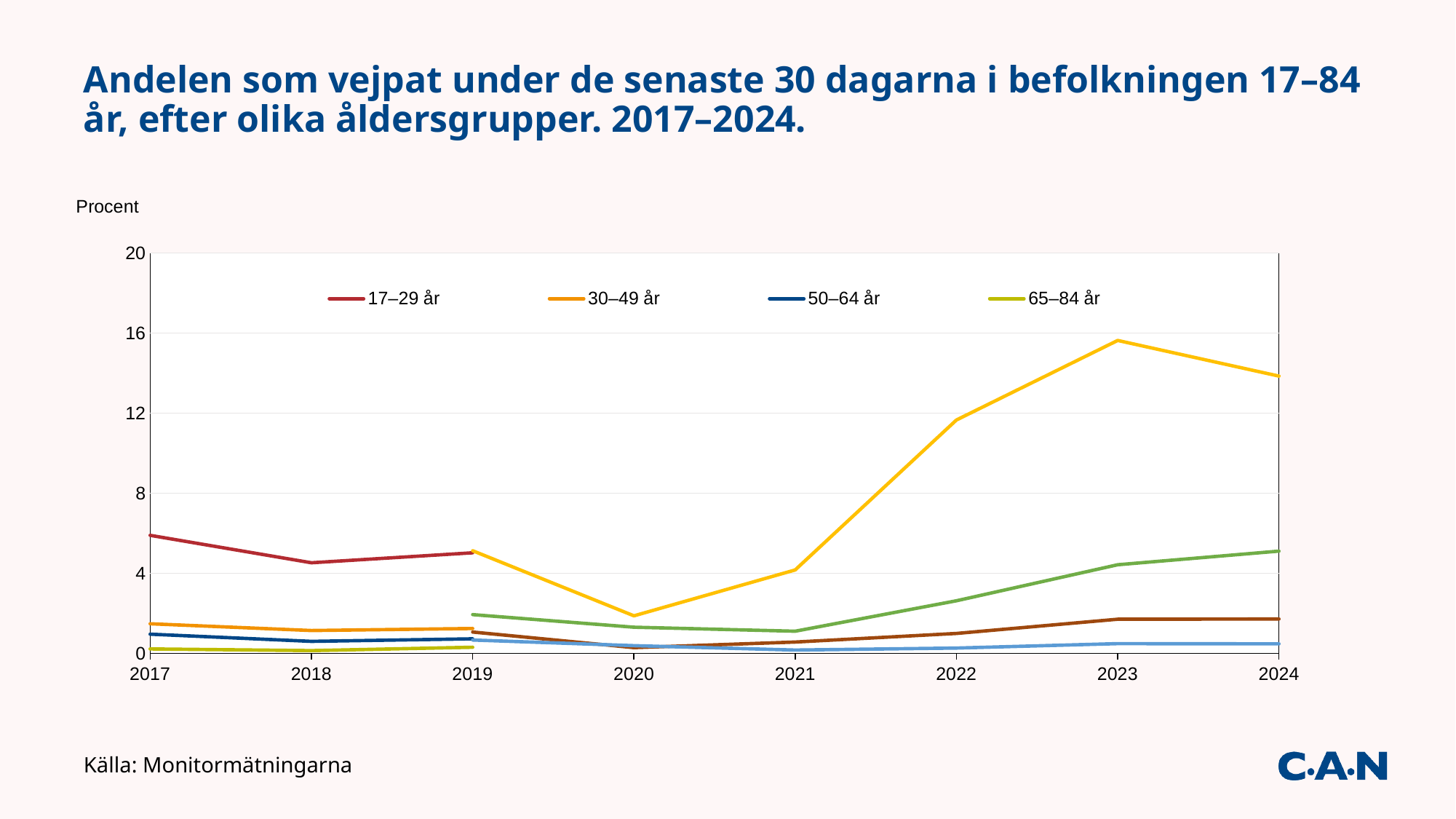
What is the label on the y axis? Procent Does the value for 17–29 år rise or fall from 2017 to 2018? fall Is the value for 17–29 år in 2017 greater or less than 8? less How many years are shown on the x axis? 8 Is the value for 30–49 år in 2017 greater or less than 4? less Is the value for 17–29 år in 2017 greater or less than 4? greater How many series does the legend list? 4 Which age group has the lowest value in 2017? 65–84 år In 2017, which is larger: the value for 17–29 år or the value for 30–49 år? 17–29 år Which age group has the highest value in 2017? 17–29 år What kind of chart is shown on the slide? line chart